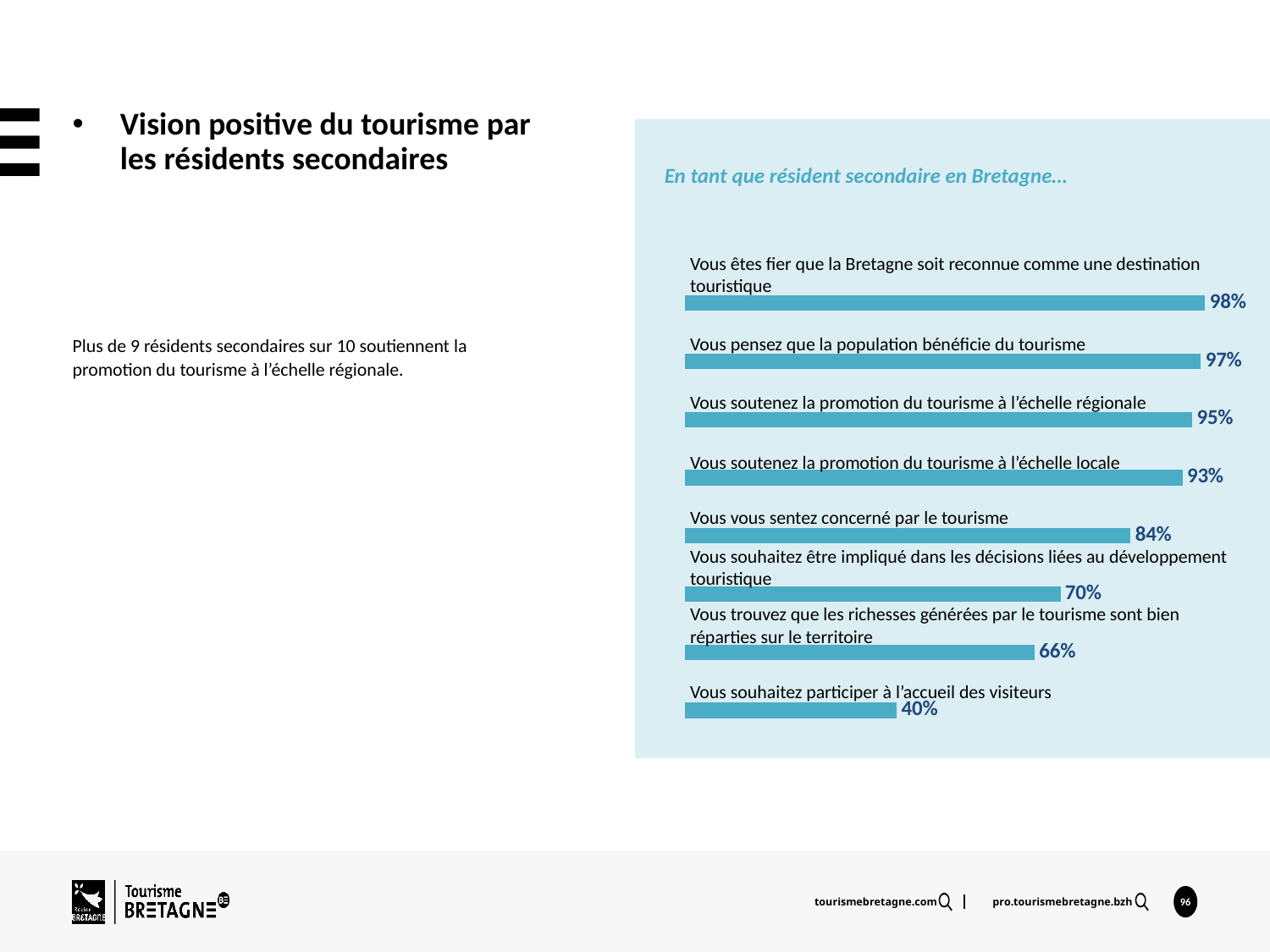
What is the value for "Vous souhaitez participer à l'accueil des visiteurs"? 40% What is the title of the chart? En tant que résident secondaire en Bretagne… Which statement has the lowest percentage? Vous souhaitez participer à l'accueil des visiteurs What is the difference between the value for "Vous pensez que la population bénéficie du tourisme" and the value for "Vous souhaitez participer à l'accueil des visiteurs"? 57% What percentage of secondary residents are proud that Brittany is recognised as a tourist destination ("Vous êtes fier que la Bretagne soit reconnue comme une destination touristique")? 98% Which statement has the highest percentage? Vous êtes fier que la Bretagne soit reconnue comme une destination touristique What kind of chart is shown on the slide? Bar chart What is the value for "Vous vous sentez concerné par le tourisme"? 84% What is the difference between the value for "Vous souhaitez être impliqué dans les décisions liées au développement touristique" and the value for "Vous trouvez que les richesses générées par le tourisme sont bien réparties sur le territoire"? 4% Which is larger: the value for "Vous soutenez la promotion du tourisme à l'échelle régionale" or the value for "Vous vous sentez concerné par le tourisme"? Vous soutenez la promotion du tourisme à l'échelle régionale How many statements (bars) are shown in the chart? 8 What is the value for "Vous soutenez la promotion du tourisme à l'échelle locale"? 93%